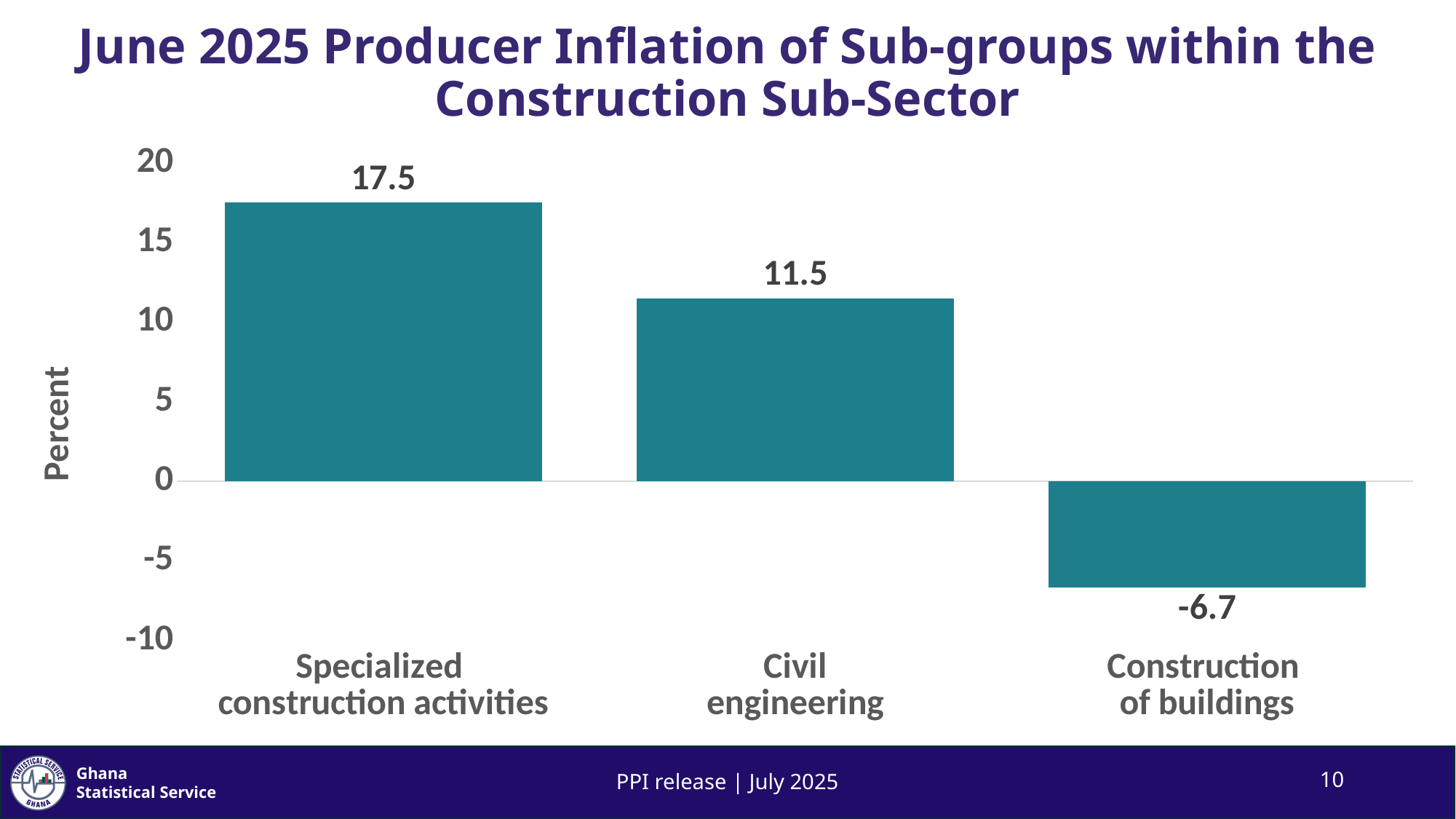
What is the difference between the values for Specialized construction activities and Civil engineering? 6.0 How many sub-groups are shown in the chart? 3 What is the producer inflation value for Civil engineering? 11.5 What is the label on the vertical axis of the chart? Percent What is the difference between the values for Civil engineering and Construction of buildings? 18.2 Which sub-group has the highest producer inflation? Specialized construction activities What is the producer inflation value for Specialized construction activities? 17.5 What kind of chart is shown on the slide? Bar chart What is the producer inflation value for Construction of buildings? -6.7 Which sub-group has the lowest producer inflation? Construction of buildings Which is larger, the value for Civil engineering or the value for Construction of buildings? Civil engineering Is the value for Specialized construction activities greater or less than 15? greater